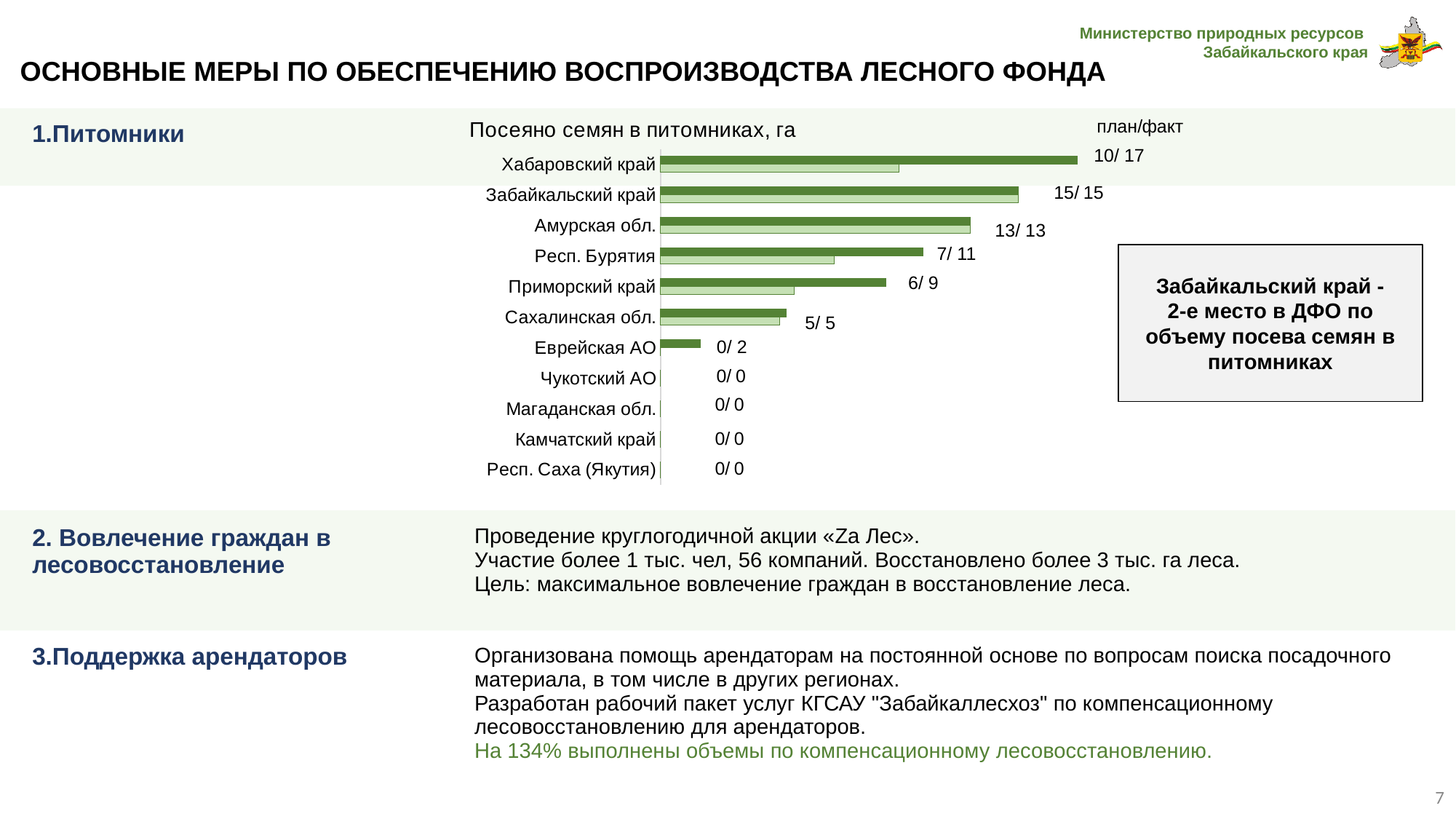
Which region has the highest факт value (second number in the label) in the chart? Хабаровский край How many regions are listed in the chart 'Посеяно семян в питомниках, га'? 11 Which has a larger факт value: Респ. Бурятия or Сахалинская обл.? Респ. Бурятия What is the difference between the факт values of Амурская обл. and Приморский край? 4 What is the план/факт label shown for Респ. Бурятия? 7/ 11 What type of chart is used to show 'Посеяно семян в питомниках, га'? Bar chart Which region has the highest план value (first number in the label) in the chart? Забайкальский край What is the difference between the факт and план values for Хабаровский край? 7 What is the план/факт label shown for Хабаровский край in the chart 'Посеяно семян в питомниках, га'? 10/ 17 What is the план/факт label shown for Забайкальский край? 15/ 15 What is the план/факт label shown for Еврейская АО? 0/ 2 How many regions show a label of 0/ 0 in the chart? 4